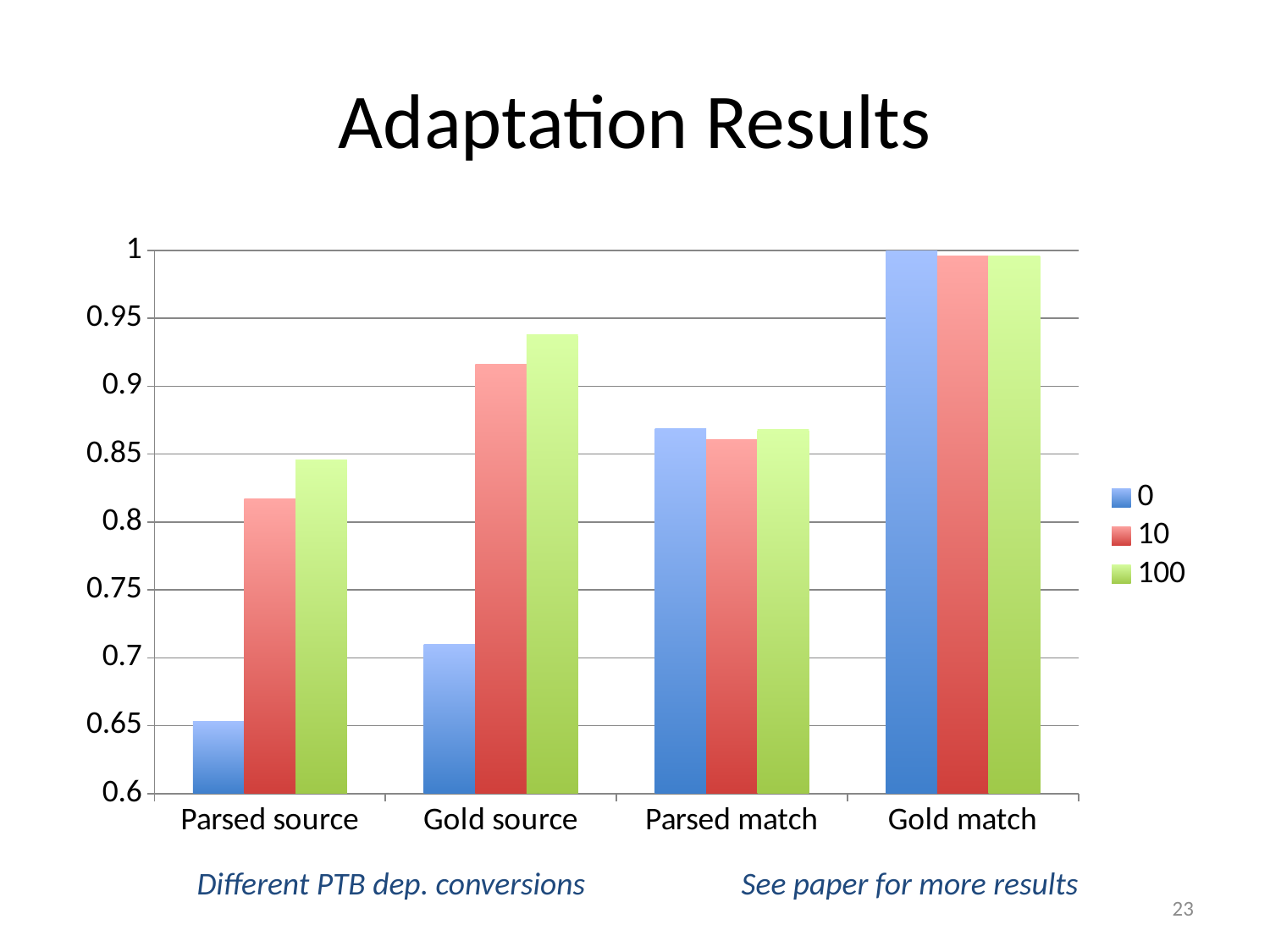
Which category has the lowest value for series 0? Parsed source What is the title of the chart? Adaptation Results Is the value for series 0 at Gold source greater or less than 0.75? less Is the value for series 100 at Parsed source greater or less than 0.8? greater What are the entries in the chart's legend? 0, 10, 100 Which category has the highest value for series 0? Gold match What kind of chart is shown on the slide? bar chart Is the value for series 0 at Parsed source greater or less than 0.7? less How many series does the legend list? 3 For series 100, which is larger: Gold source or Parsed match? Gold source How many categories are shown on the x axis? 4